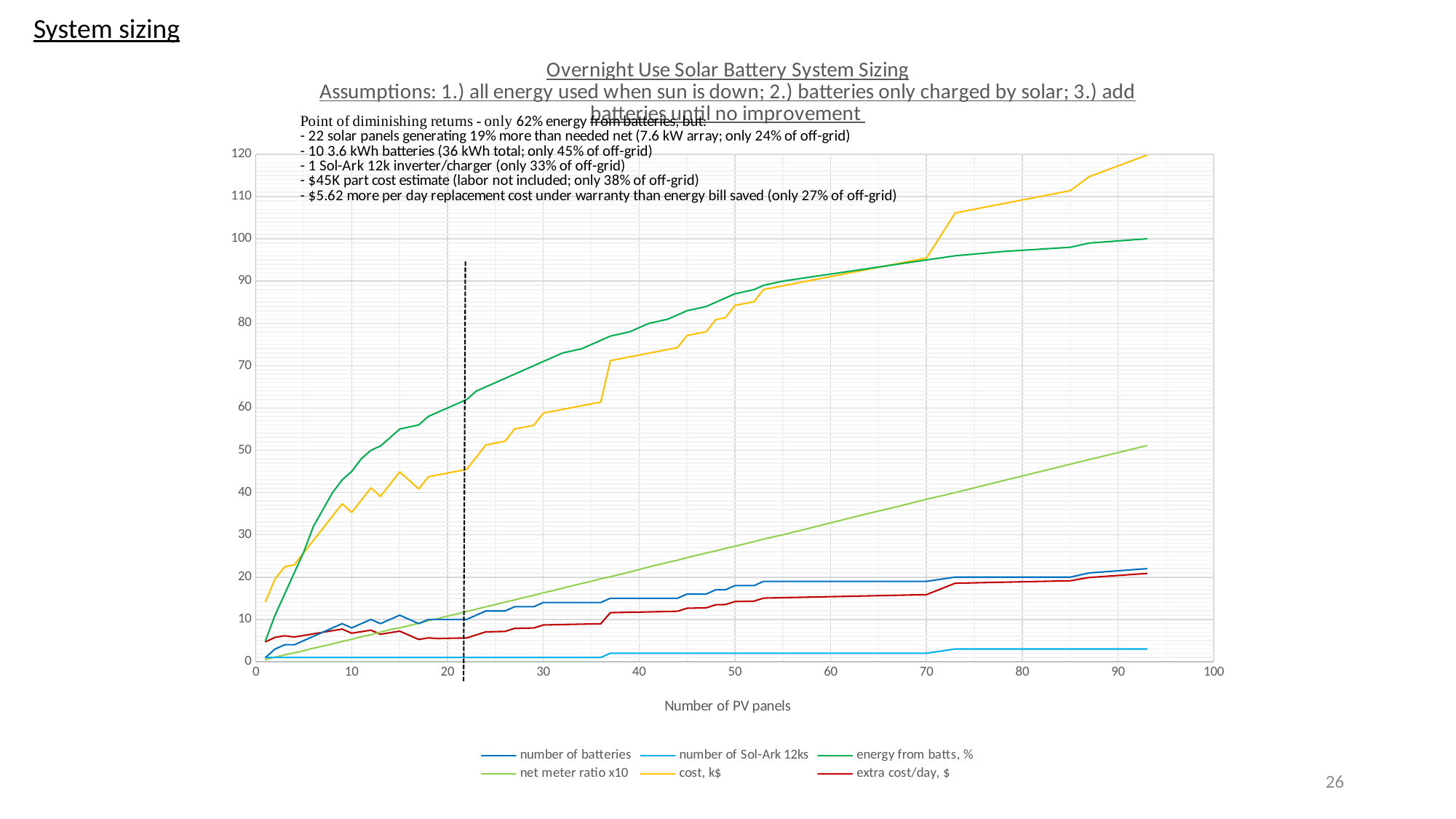
What kind of chart is shown on the slide? line chart How many series does the chart legend list? 6 Is the value of 'net meter ratio x10' at 80 PV panels greater or less than 50? less Does the 'cost, k$' series rise or fall as the number of PV panels increases? rise Is the value of 'number of Sol-Ark 12ks' at 50 PV panels greater or less than 10? less What is the title of the x axis of the chart? Number of PV panels Is the value of 'energy from batts, %' at 10 PV panels greater or less than 30? greater Does the 'energy from batts, %' series rise or fall as the number of PV panels increases? rise At 90 PV panels, which series has the larger value: 'net meter ratio x10' or 'number of batteries'? net meter ratio x10 Which series is drawn in yellow in the chart? cost, k$ At 30 PV panels, which series has the larger value: 'energy from batts, %' or 'cost, k$'? energy from batts, %